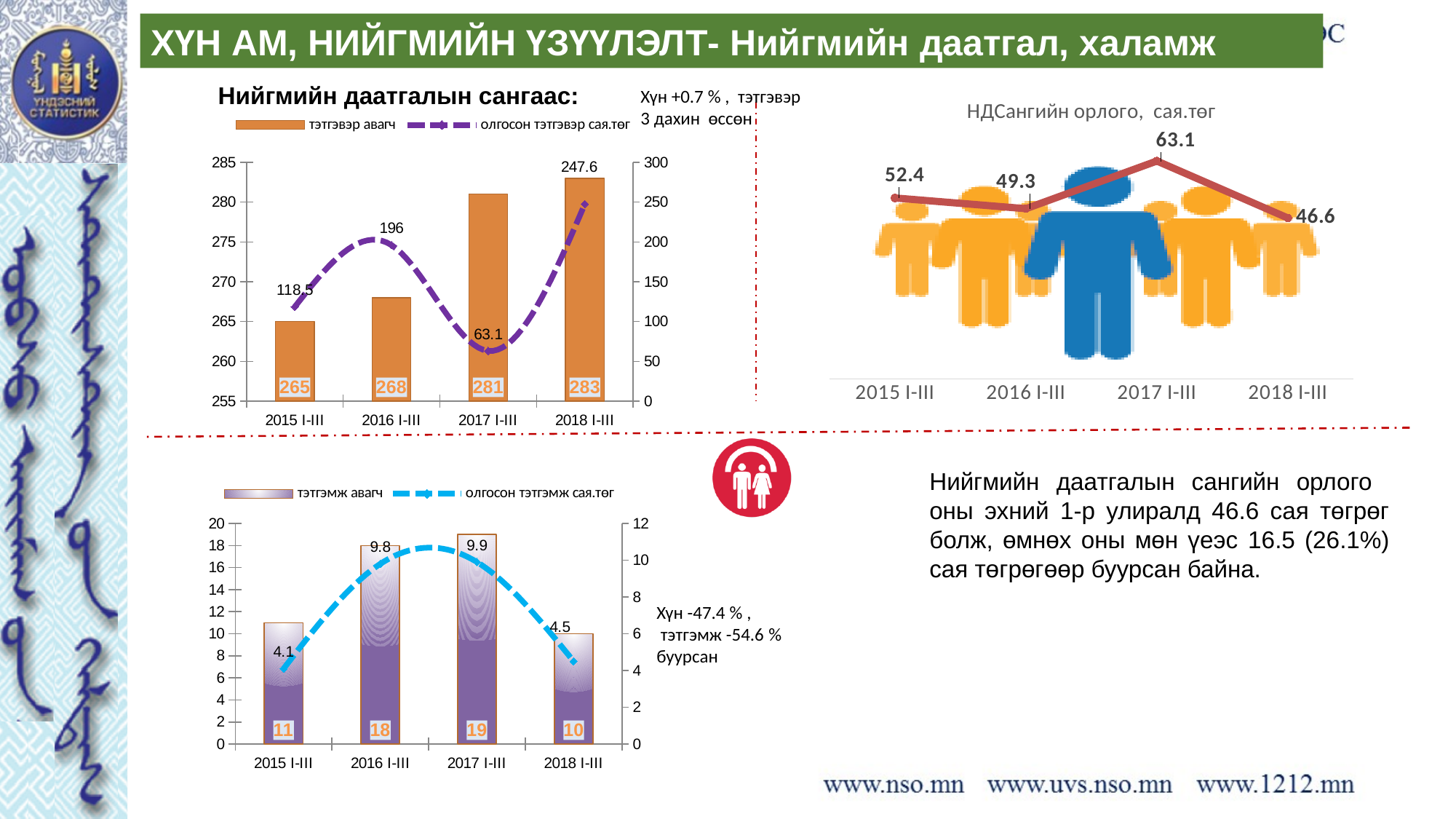
In the top-right chart (НДСангийн орлого, сая.төг), which period has the lowest value? 2018 I-III In the bottom-left chart (тэтгэмж авагч), what is the value of the bar for 2016 I-III? 18 In the top-left chart (Нийгмийн даатгалын сангаас), what is the difference between the тэтгэвэр авагч bars for 2018 I-III and 2015 I-III? 18 In the top-left chart (Нийгмийн даатгалын сангаас), which period has the lowest олгосон тэтгэвэр value? 2017 I-III In the top-right chart (НДСангийн орлого, сая.төг), how many periods are plotted? 4 In the top-left chart (Нийгмийн даатгалын сангаас), how many series does the legend list? 2 In the bottom-left chart (тэтгэмж авагч), is the bar for 2018 I-III larger or smaller than the bar for 2015 I-III? smaller In the top-right chart (НДСангийн орлого, сая.төг), what is the difference between the 2015 I-III and 2016 I-III values? 3.1 In the top-left chart (Нийгмийн даатгалын сангаас), what is the олгосон тэтгэвэр value for 2016 I-III? 196 In the top-right chart (НДСангийн орлого, сая.төг), what is the value for 2017 I-III? 63.1 In the bottom-left chart (тэтгэмж авагч), which period has the highest олгосон тэтгэмж value? 2017 I-III In the top-left chart (Нийгмийн даатгалын сангаас), what is the value of the тэтгэвэр авагч bar for 2017 I-III? 281